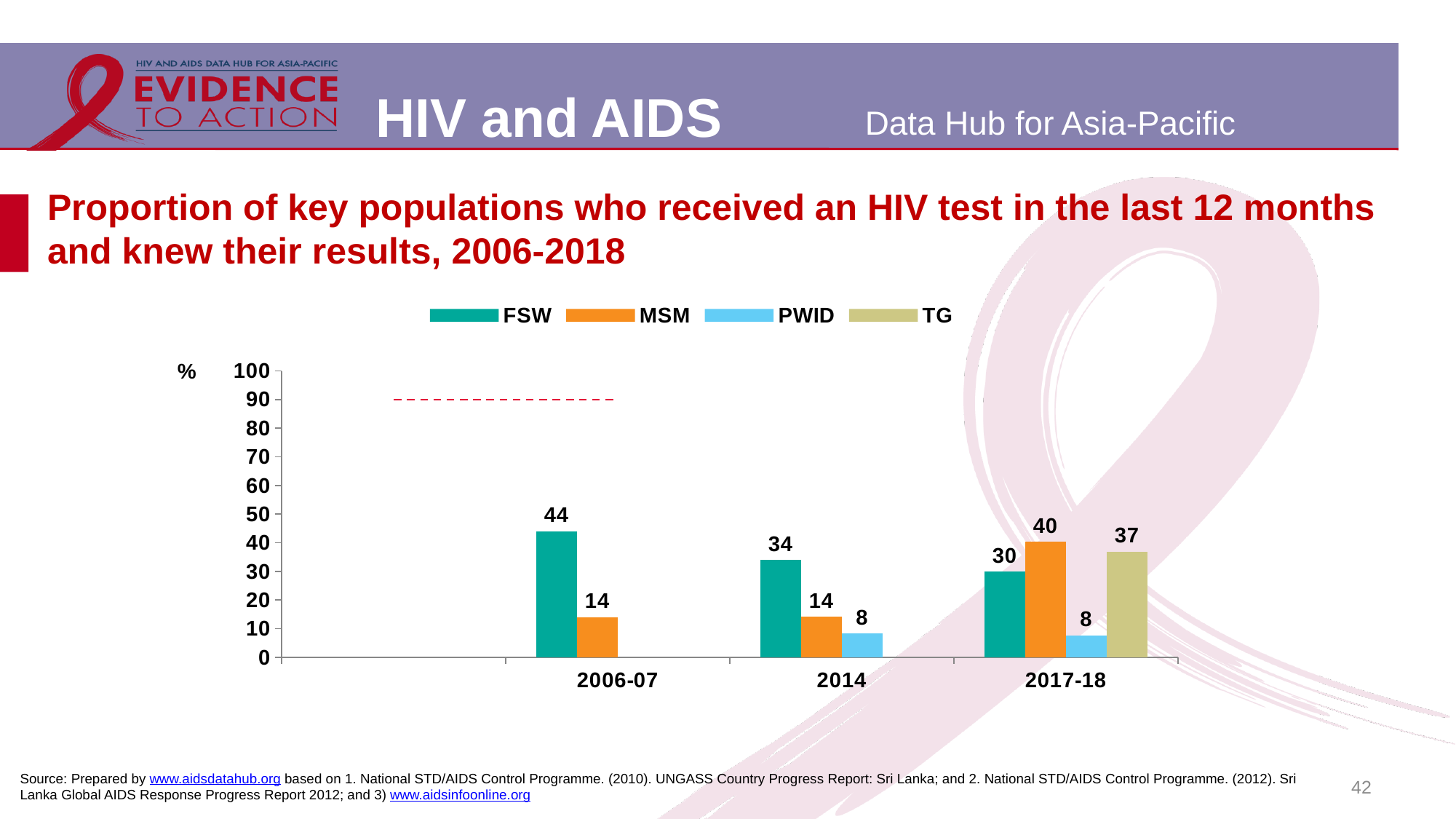
What is the value for MSM in 2017-18? 40 Which series has the highest value in 2017-18? MSM How many time periods are shown on the x axis? 3 What is the value for FSW in 2006-07? 44 What is the value for PWID in 2014? 8 Which is larger in 2014, the FSW value or the MSM value? FSW What kind of chart is shown on the slide? Bar chart Which series has the lowest value in 2017-18? PWID What is the difference between the FSW value in 2006-07 and the FSW value in 2017-18? 14 What is the value for TG in 2017-18? 37 Do the FSW values rise or fall from 2006-07 to 2017-18? Fall How many series does the legend list? 4